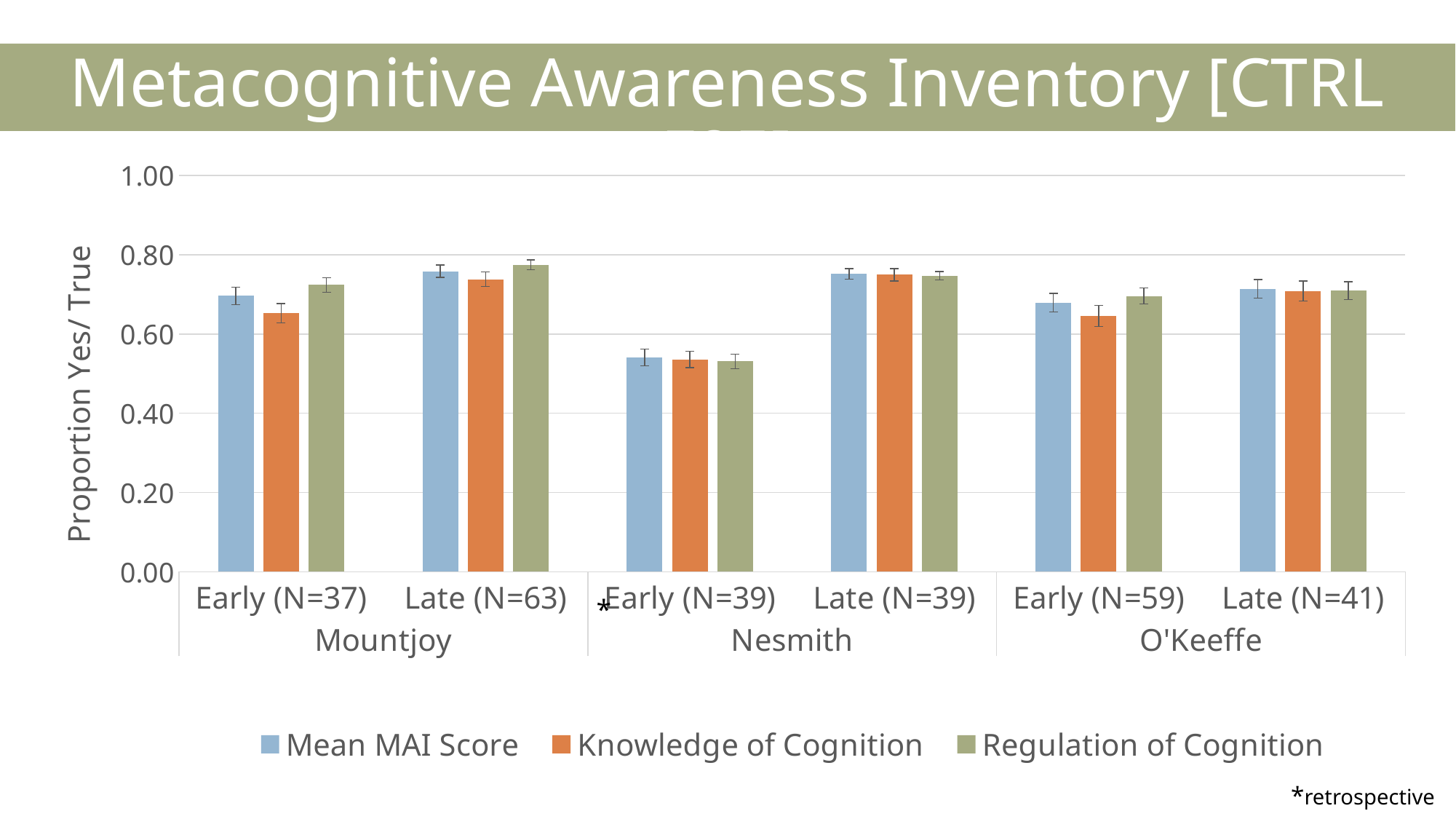
For Nesmith, is the Mean MAI Score larger for Early (N=39) or Late (N=39)? Late (N=39) Is the Mean MAI Score for Nesmith Early (N=39) greater or less than 0.60? less Is the Knowledge of Cognition value for Nesmith Early (N=39) greater or less than 0.60? less What is the label on the y axis? Proportion Yes/ True For O'Keeffe Early (N=59), which is larger: Knowledge of Cognition or Regulation of Cognition? Regulation of Cognition Is the Mean MAI Score for Mountjoy Late (N=63) greater or less than 0.80? less What kind of chart is shown on the slide? bar chart For Mountjoy Early (N=37), which is larger: Mean MAI Score or Knowledge of Cognition? Mean MAI Score How many Early/Late category groups are shown along the x axis? 6 How many series does the legend list? 3 Which category group has the lowest Mean MAI Score? Nesmith Early (N=39)